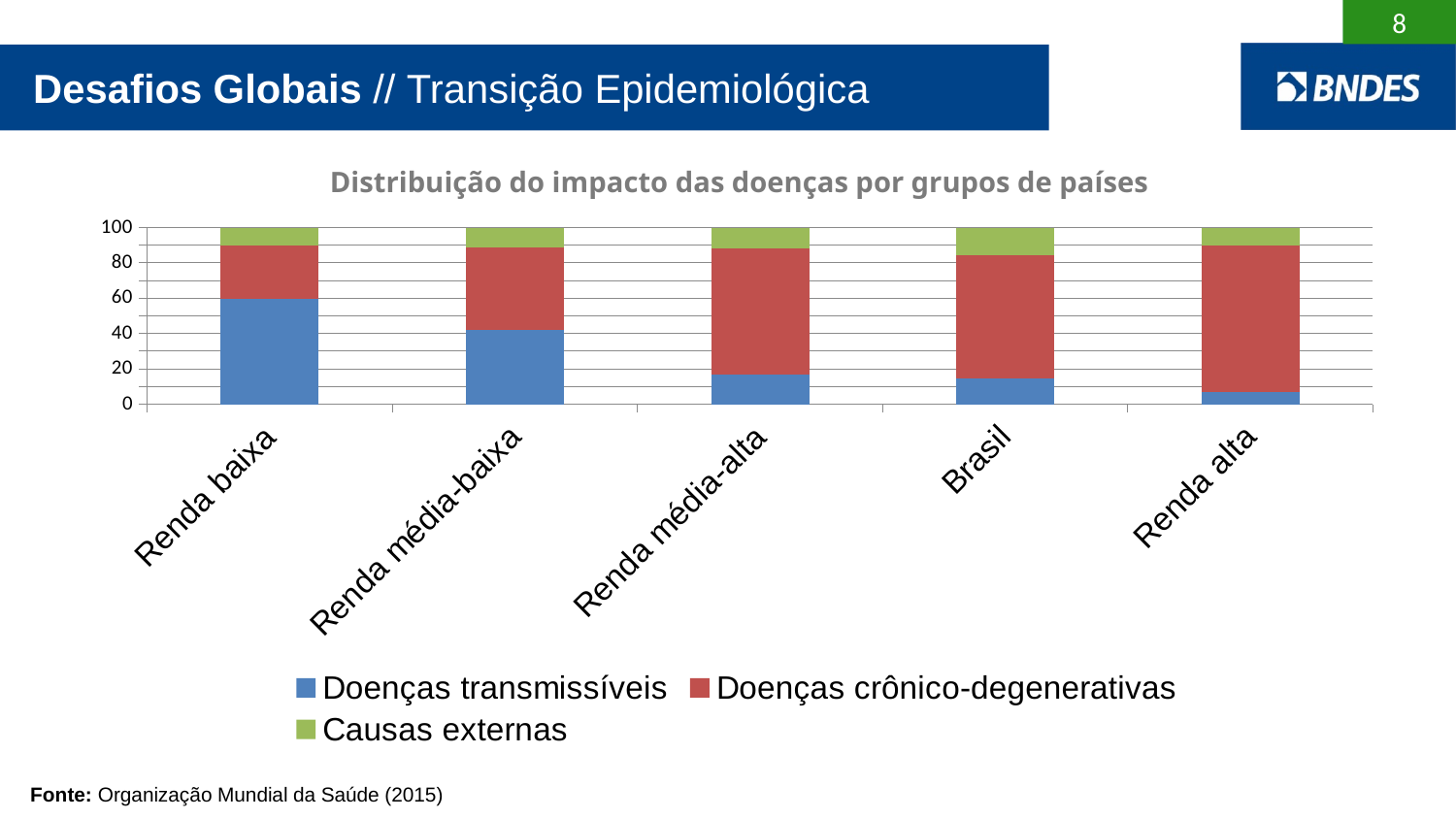
How many series does the legend list? 3 Is the value for Doenças transmissíveis in Renda média-baixa greater or less than 20? greater Which series is shown in blue in the legend? Doenças transmissíveis How many country groups (categories) are shown on the x axis? 5 Does the value for Doenças transmissíveis rise or fall moving from Renda baixa to Renda alta along the x axis? Fall Which has a larger value for Doenças transmissíveis, Renda baixa or Renda média-baixa? Renda baixa What is the title of the chart? Distribuição do impacto das doenças por grupos de países Which category has the highest value for Doenças transmissíveis? Renda baixa Is the value for Doenças transmissíveis in Renda alta greater or less than 20? less Is the value for Doenças transmissíveis in Renda baixa greater or less than 40? greater What kind of chart is shown on the slide? Stacked bar chart Which category has the lowest value for Doenças transmissíveis? Renda alta